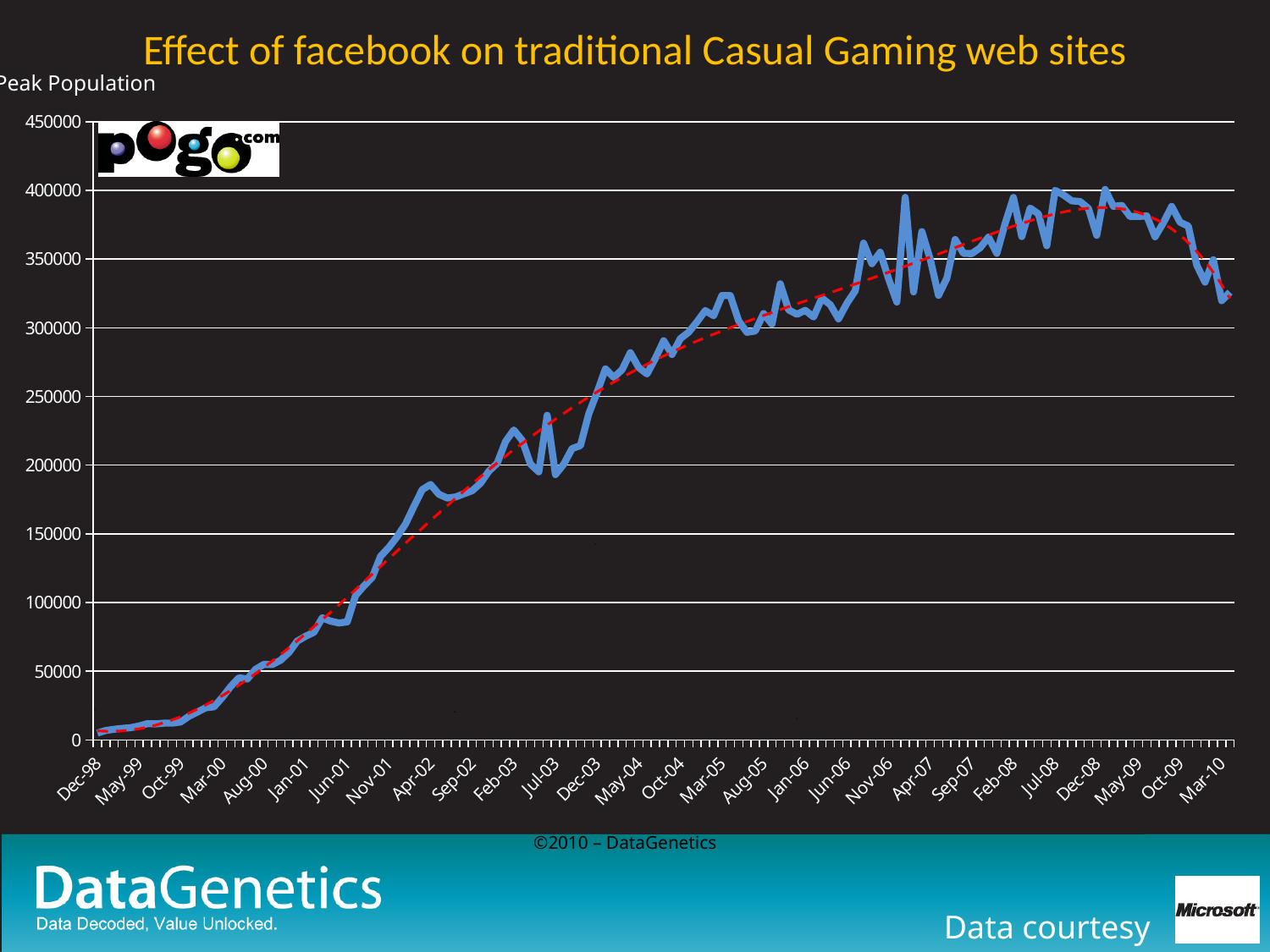
Is the Peak Population value for Jun-01 greater or less than 100000? less What kind of chart is shown on the slide? line chart Is the Peak Population value for Dec-98 greater or less than 50000? less Is the Peak Population value for Mar-10 greater or less than 300000? greater What is the title of the slide's chart? Effect of facebook on traditional Casual Gaming web sites Which is larger, the Peak Population for Mar-05 or for Jan-01? Mar-05 Which date on the x axis has the lowest Peak Population? Dec-98 Does the Peak Population generally rise or fall between Dec-98 and Jul-08? rise What is the label on the vertical axis of the chart? Peak Population Does the Peak Population rise or fall between May-09 and Mar-10? fall